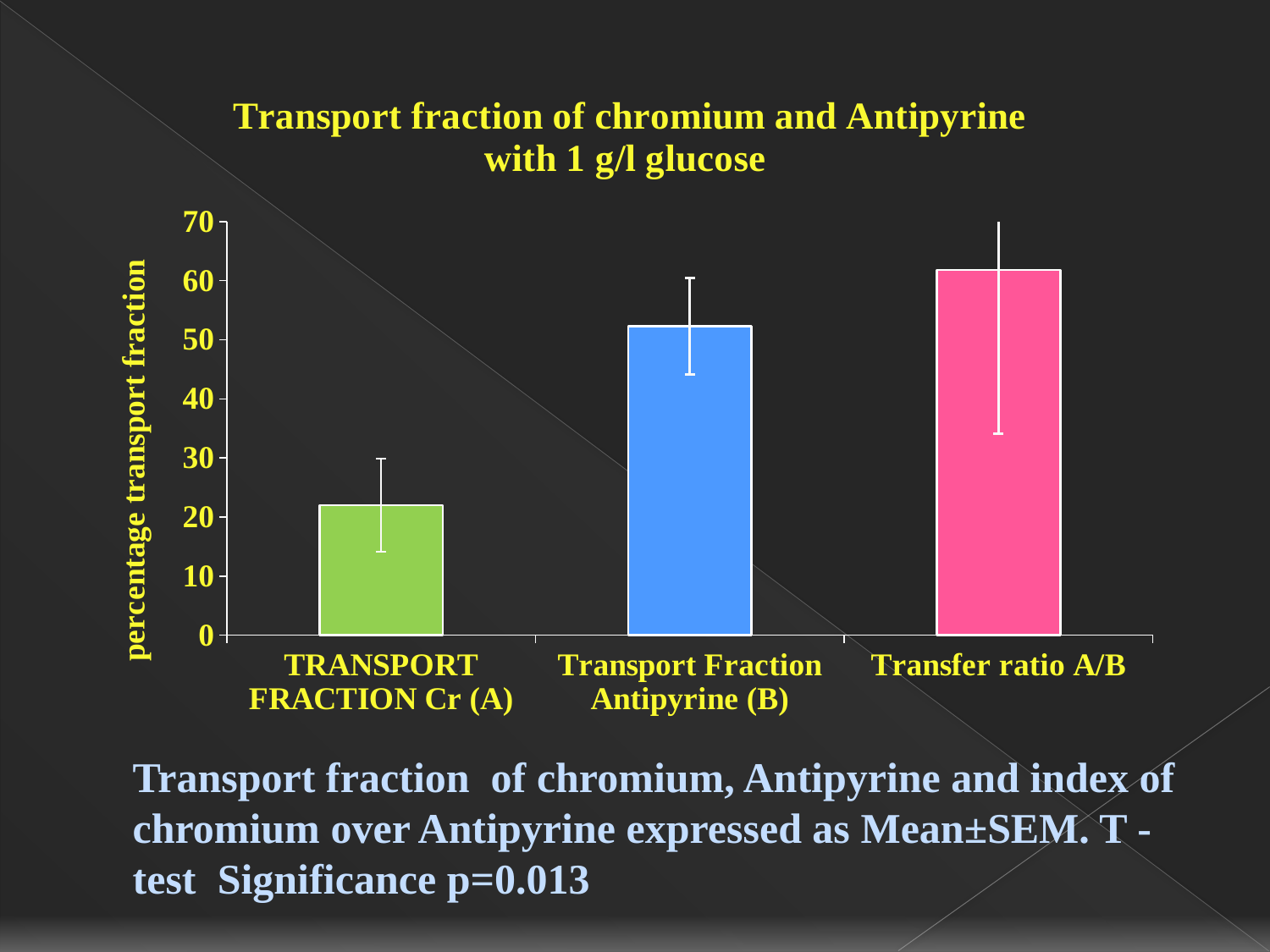
Is the value for Transport Fraction Antipyrine (B) greater or less than 50? greater What is the title of the chart? Transport fraction of chromium and Antipyrine with 1 g/l glucose Do the bar values rise or fall from left to right across the categories? rise What kind of chart is shown on the slide? bar chart Is the value for Transfer ratio A/B greater or less than 60? greater Is the value for TRANSPORT FRACTION Cr (A) greater or less than 20? greater Which category has the highest bar? Transfer ratio A/B Which category has the lowest bar? TRANSPORT FRACTION Cr (A) What is the label on the vertical axis of the chart? percentage transport fraction How many bars (categories) are plotted in the chart? 3 Which is larger, the bar for Transport Fraction Antipyrine (B) or the bar for TRANSPORT FRACTION Cr (A)? Transport Fraction Antipyrine (B)